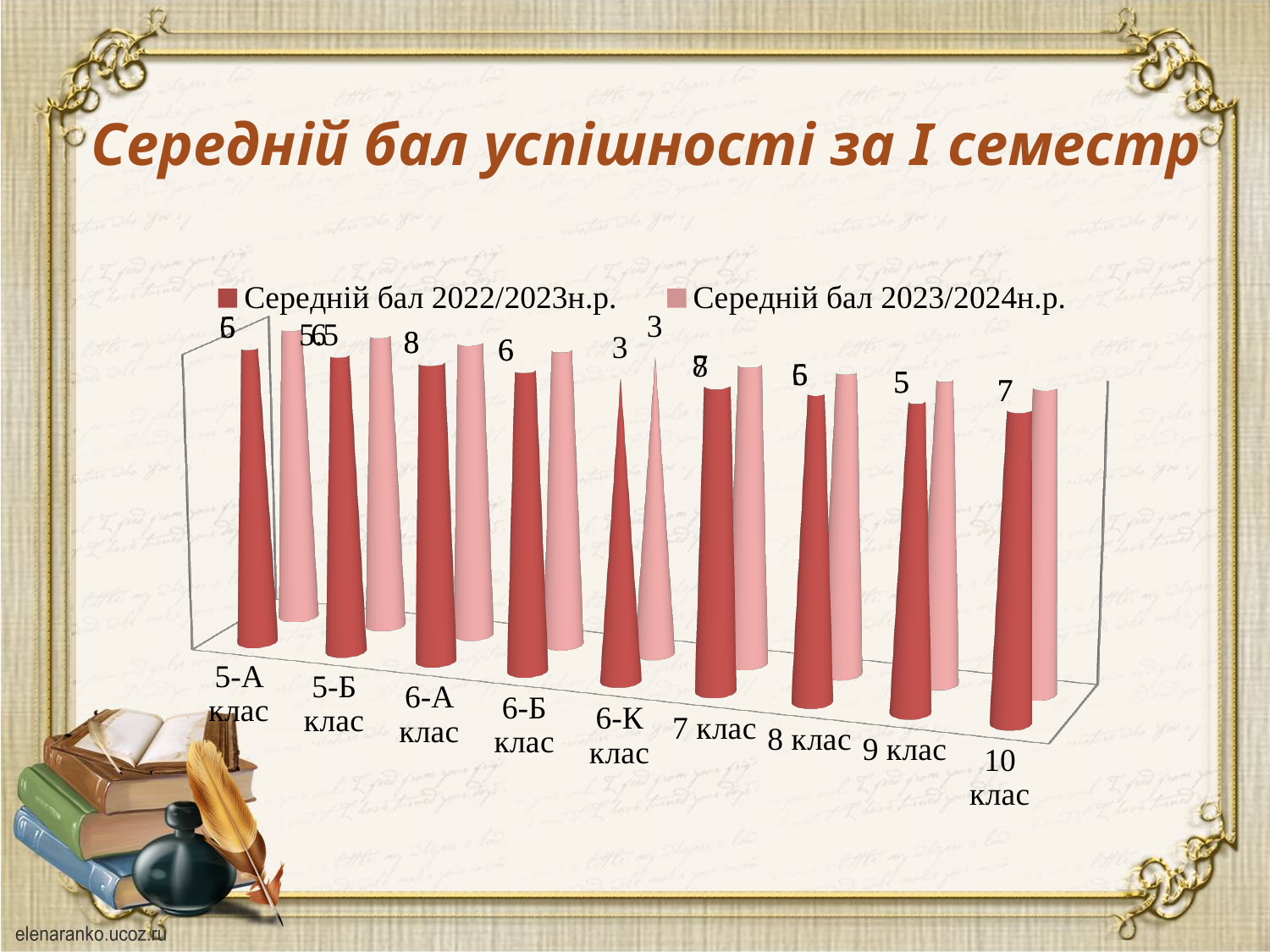
For the series Середній бал 2022/2023н.р., which is larger: the value for 5-А клас or the value for 9 клас? Neither; both are 5 What kind of chart is shown on the slide? bar chart How many classes (categories) are shown on the x axis? 9 For the series Середній бал 2022/2023н.р., which is larger: the value for 6-А клас or the value for 10 клас? 6-А клас Which category is the first one on the x axis? 5-А клас What are the two legend entries of the chart? Середній бал 2022/2023н.р. and Середній бал 2023/2024н.р. For the series Середній бал 2022/2023н.р., which is larger: the value for 5-А клас or the value for 10 клас? 10 клас How many series does the legend list? 2 What is the title of the slide's chart? Середній бал успішності за І семестр